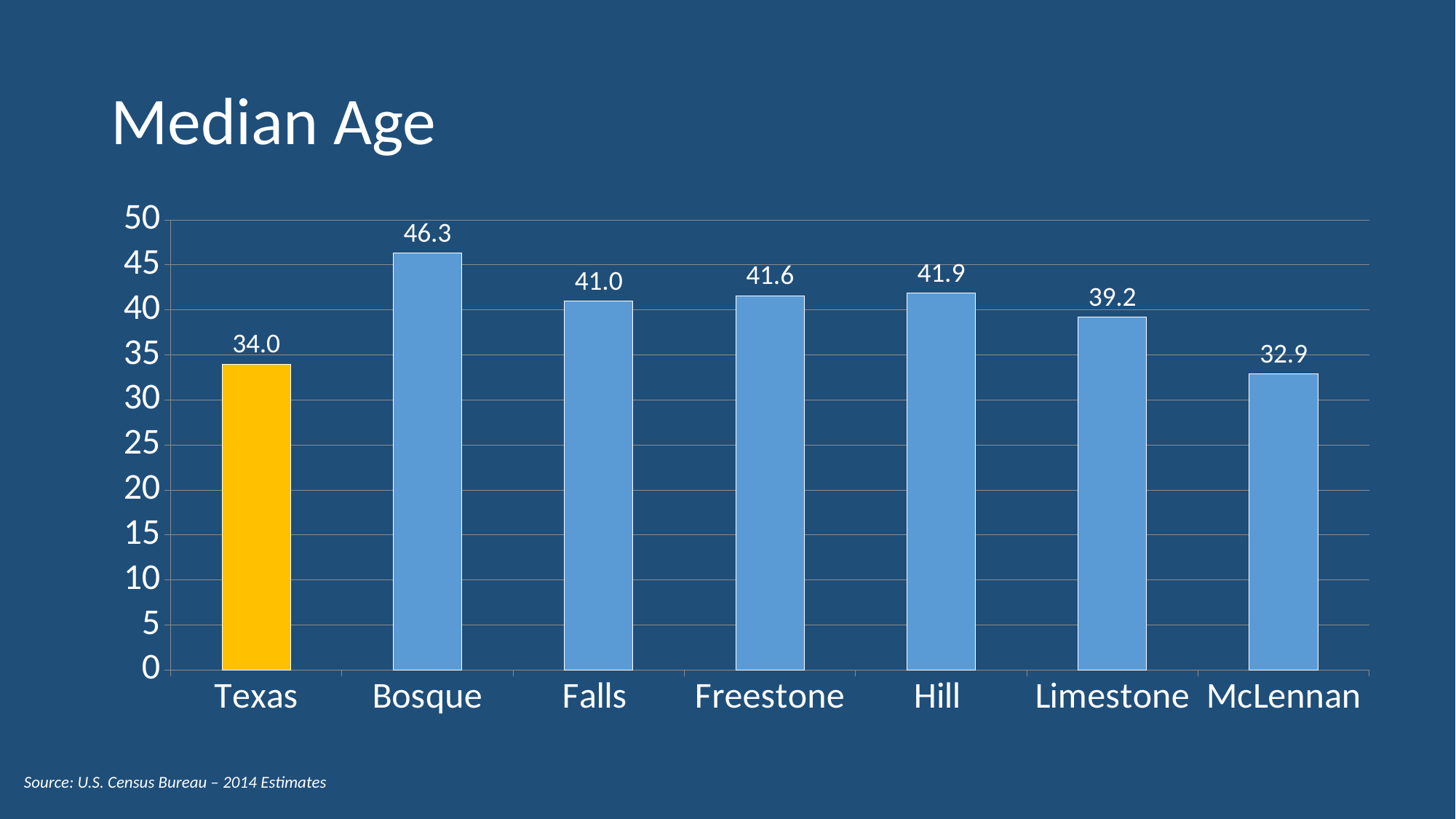
Which has a higher median age, Hill or Limestone? Hill What is the title of the chart? Median Age Which category has the lowest median age? McLennan What is the median age shown for Bosque? 46.3 Which category has the highest median age? Bosque Is the value for Freestone greater or less than 40? greater What is the difference between the median age of Bosque and the median age of Texas? 12.3 What kind of chart is shown on the slide? Bar chart What is the median age shown for Texas? 34.0 How many categories are shown on the x axis? 7 What is the median age shown for Limestone? 39.2 Which bar is coloured differently (yellow) from the others? Texas